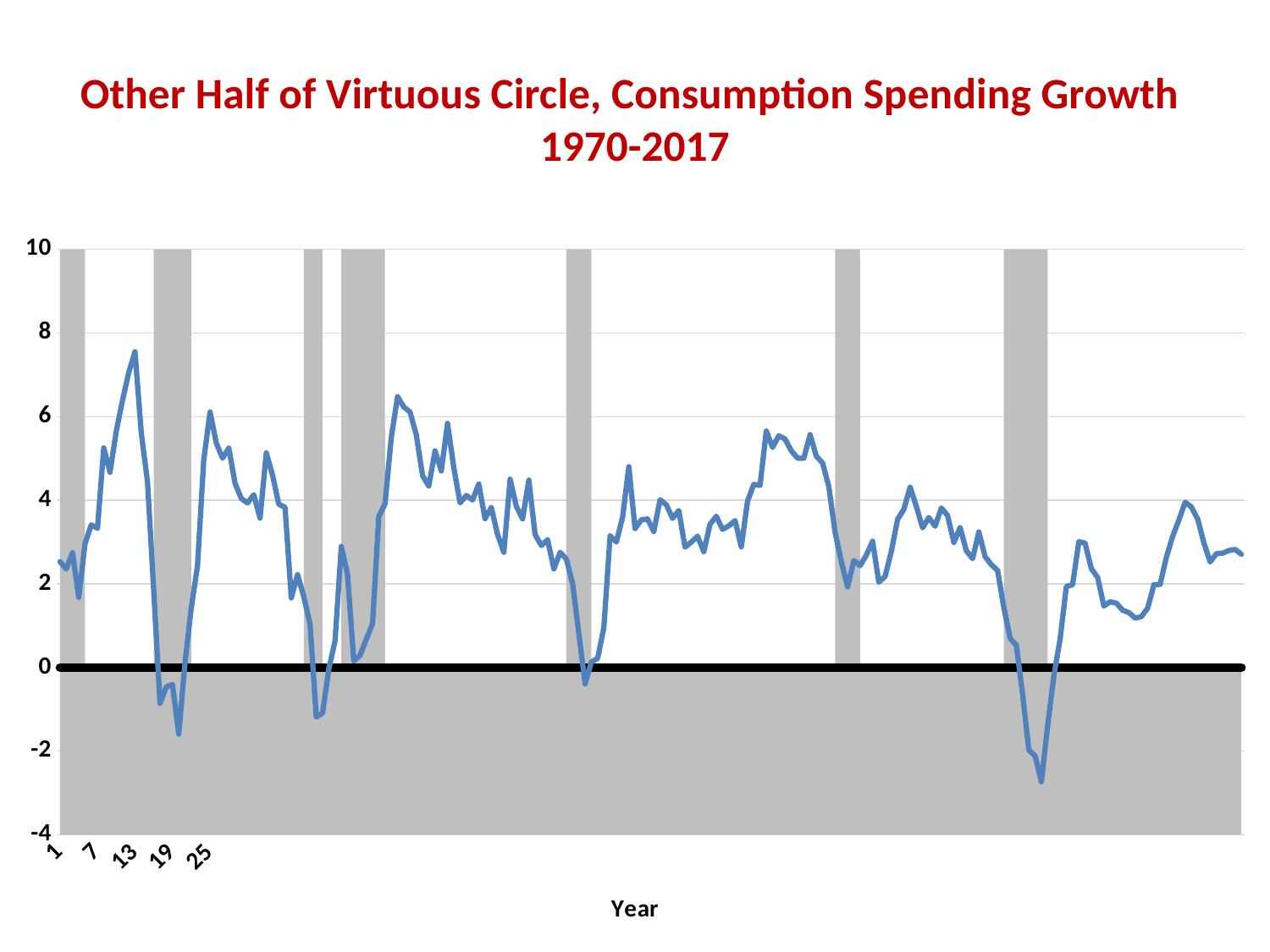
Is the value at year 13 greater or less than 6? greater What is the highest value shown on the y axis? 10 What is the label on the x axis of the chart? Year Is the value at year 7 greater or less than 2? greater Is the value at year 25 greater or less than 4? greater Which is larger, the value at year 13 or the value at year 19? year 13 What kind of chart is shown on the slide? line chart What is the lowest value shown on the y axis? -4 Does the line rise or fall between year 13 and year 19? fall Near which labelled year does the line reach its highest value? 13 What is the title of the chart? Other Half of Virtuous Circle, Consumption Spending Growth 1970-2017